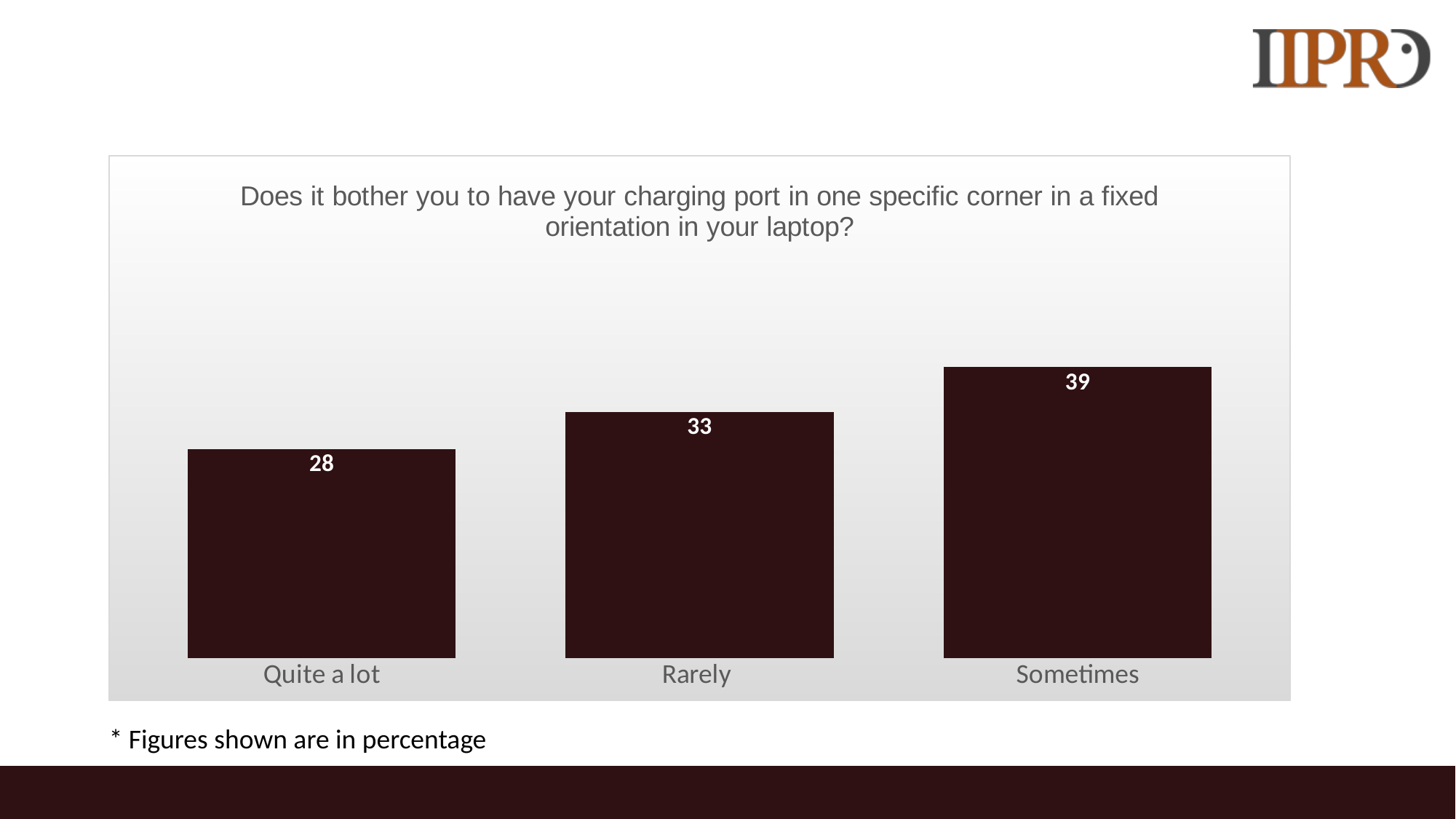
Which category has the lowest value? Quite a lot What kind of chart is shown on the slide? Bar chart How many categories are shown in the chart? 3 What is the difference between the values for "Rarely" and "Quite a lot"? 5 What is the title of the chart? Does it bother you to have your charging port in one specific corner in a fixed orientation in your laptop? What is the value for "Rarely"? 33 What is the value for "Quite a lot"? 28 What is the difference between the values for "Sometimes" and "Quite a lot"? 11 What is the value for "Sometimes"? 39 Which is larger, the value for "Rarely" or the value for "Sometimes"? Sometimes Do the values rise or fall from left to right across the categories? Rise Which category has the highest value? Sometimes